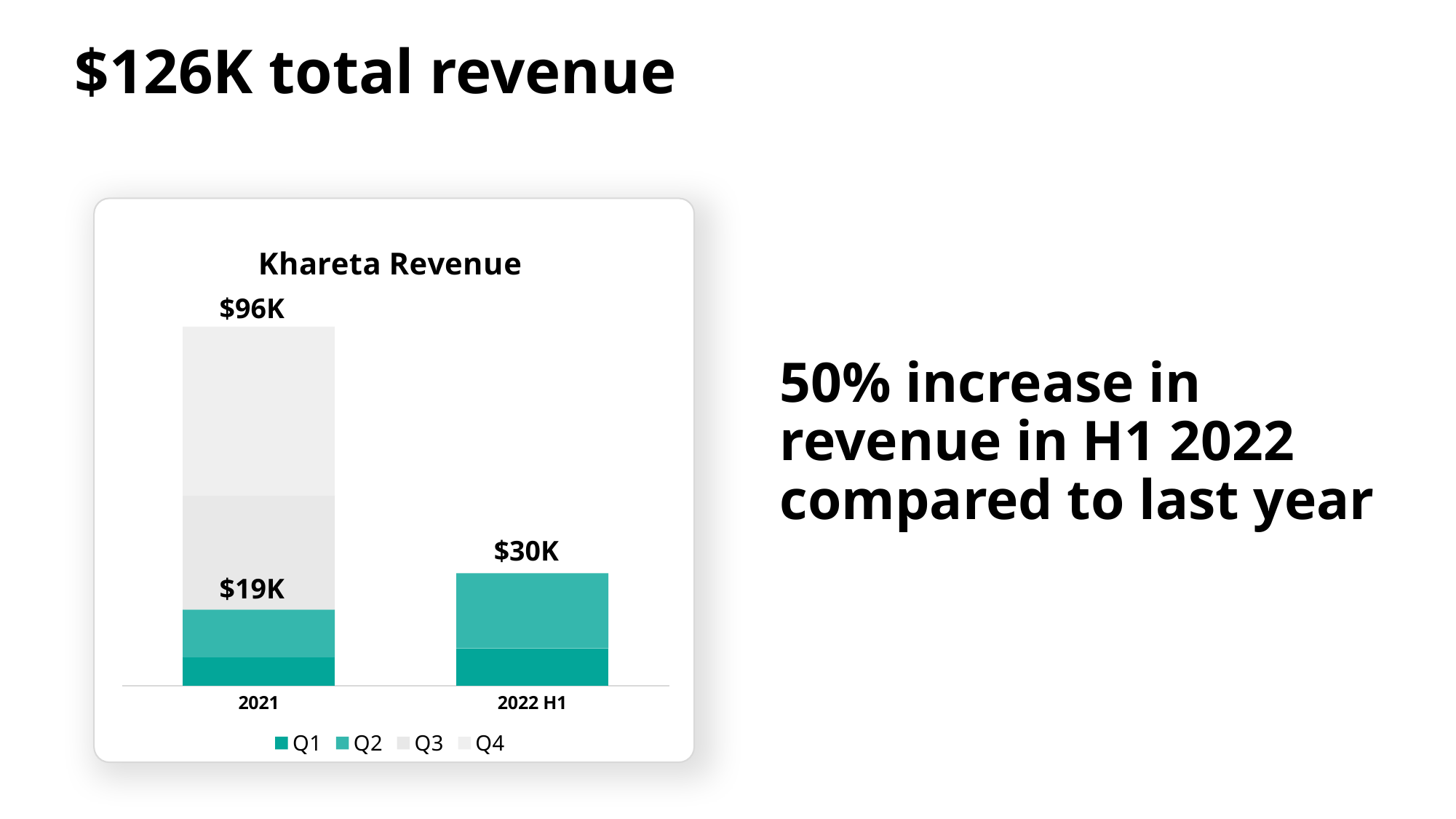
Which category has the lowest total bar? 2022 H1 How many series does the chart legend list? 4 What value is labelled just above the Q2 segment of the 2021 bar? $19K What is the title of the chart? Khareta Revenue What is the total revenue labelled for the 2022 H1 bar? $30K Which series in the legend are shown in grey rather than teal? Q3 and Q4 Which is larger, the total for 2021 or the total for 2022 H1? 2021 What is the total revenue labelled for the 2021 bar? $96K What is the difference between the 2021 total ($96K) and the 2022 H1 total ($30K)? $66K Which category has the highest total bar? 2021 How many categories are shown on the x axis of the chart? 2 What type of chart is shown on the slide? bar chart